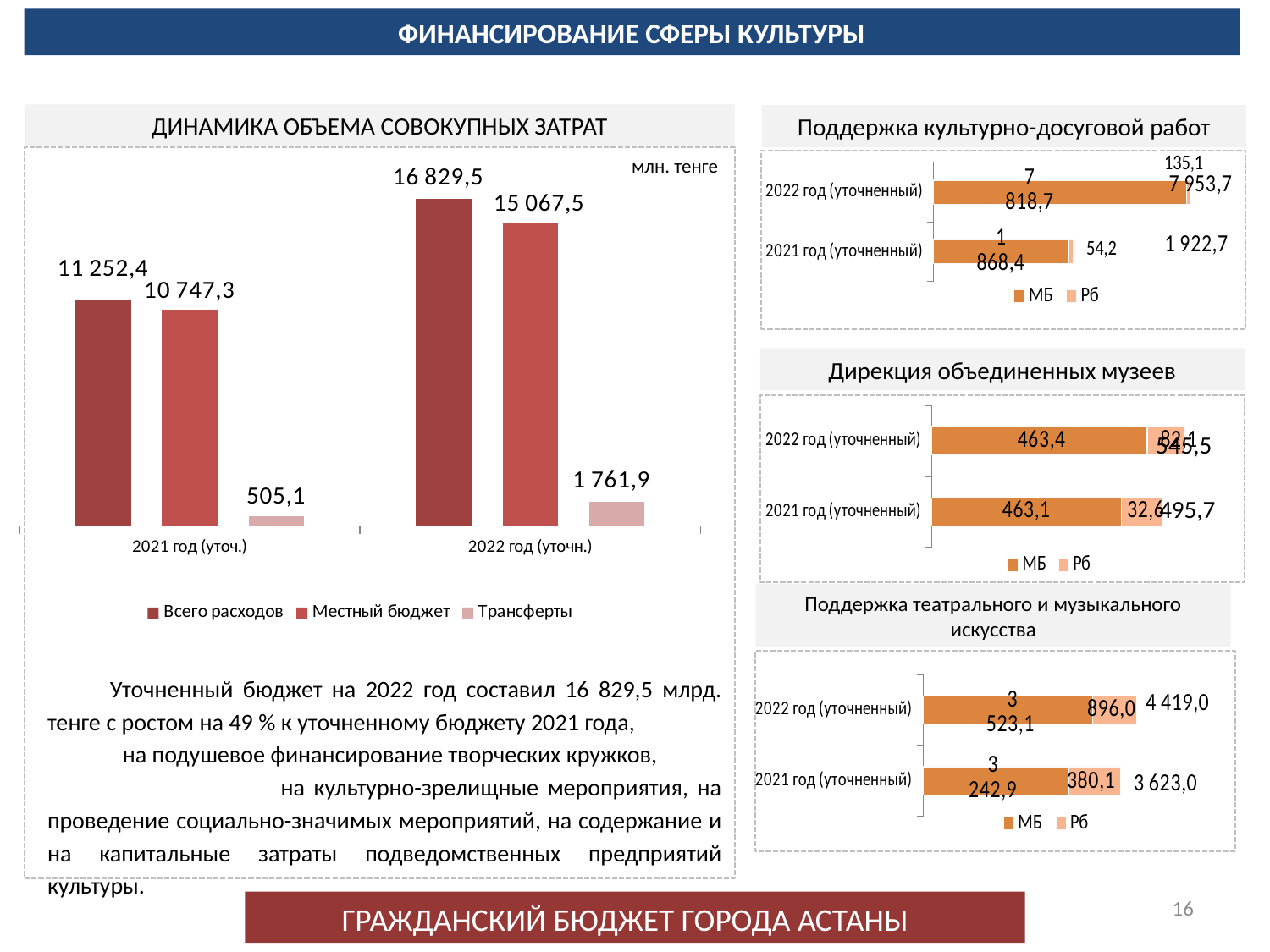
In the chart 'ДИНАМИКА ОБЪЕМА СОВОКУПНЫХ ЗАТРАТ', what is the value of 'Трансферты' for 2021 год (уточ.)? 505,1 In the chart 'Поддержка культурно-досуговой работ', what is the МБ value for 2022 год (уточненный)? 7 818,7 In the chart 'Поддержка культурно-досуговой работ', what is the total of the stacked bar for 2021 год (уточненный)? 1 922,7 In the chart 'Поддержка театрального и музыкального искусства', what is the difference between the Рб values for 2022 and 2021? 515,9 In the chart 'Поддержка театрального и музыкального искусства', what is the Рб value for 2022 год (уточненный)? 896,0 What kind of chart is 'ДИНАМИКА ОБЪЕМА СОВОКУПНЫХ ЗАТРАТ'? Bar chart In the chart 'Дирекция объединенных музеев', what is the Рб value for 2021 год (уточненный)? 32,6 In the chart 'Дирекция объединенных музеев', which year has the larger МБ value, 2021 or 2022? 2022 год (уточненный) In the chart 'ДИНАМИКА ОБЪЕМА СОВОКУПНЫХ ЗАТРАТ', how many series does the legend list? 3 In the chart 'ДИНАМИКА ОБЪЕМА СОВОКУПНЫХ ЗАТРАТ', does 'Местный бюджет' rise or fall from 2021 to 2022? Rise In the chart 'ДИНАМИКА ОБЪЕМА СОВОКУПНЫХ ЗАТРАТ', what is the value of 'Всего расходов' for 2022 год (уточн.)? 16 829,5 In the chart 'ДИНАМИКА ОБЪЕМА СОВОКУПНЫХ ЗАТРАТ', what is the difference between 'Всего расходов' in 2022 год (уточн.) and in 2021 год (уточ.)? 5 577,1